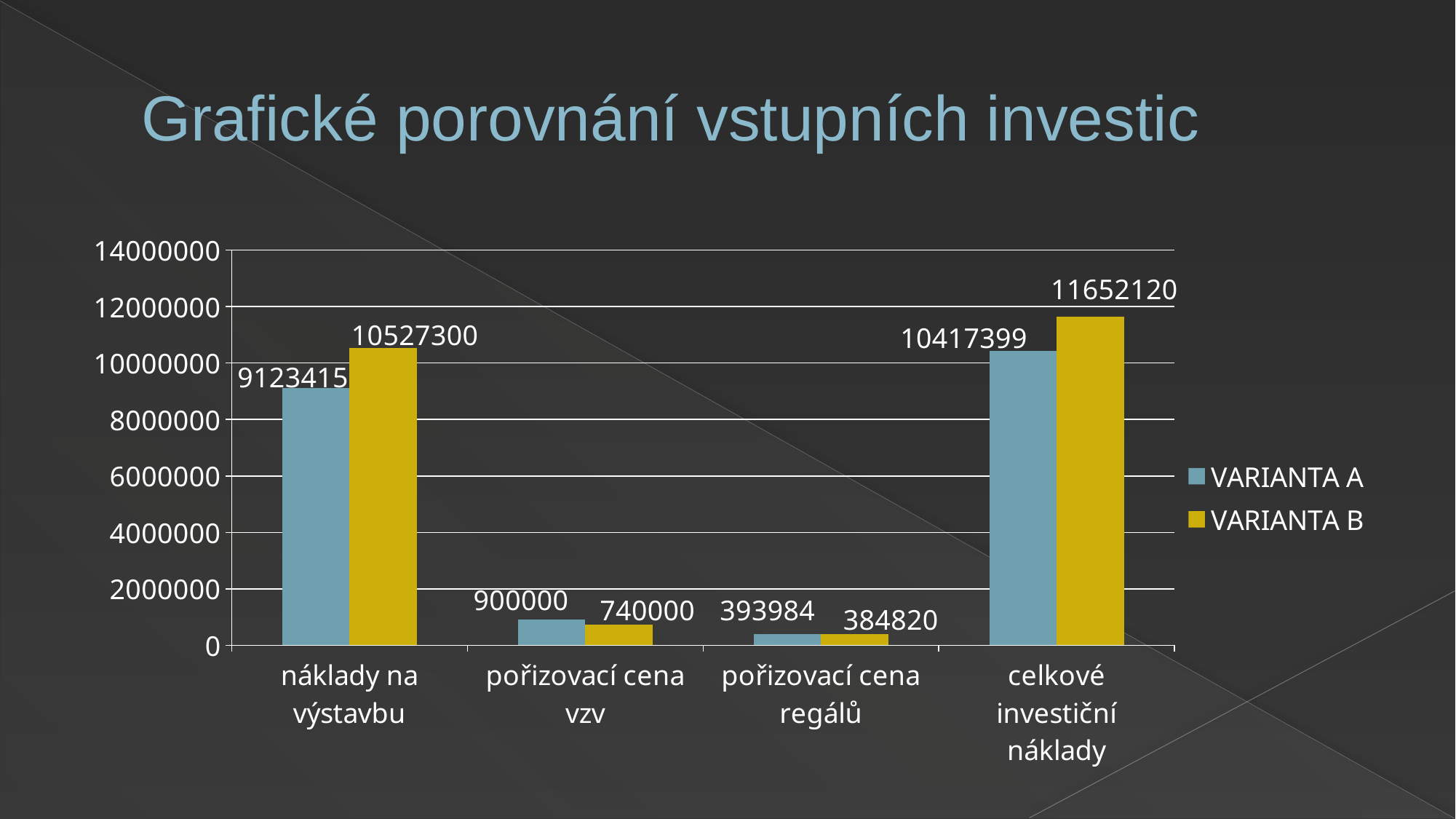
What is the value for VARIANTA B in the 'celkové investiční náklady' category? 11652120 How many categories are shown on the x axis? 4 In the 'pořizovací cena vzv' category, which series has the larger value, VARIANTA A or VARIANTA B? VARIANTA A What kind of chart is shown on the slide? bar chart What is the value for VARIANTA A in the 'pořizovací cena regálů' category? 393984 What is the difference between VARIANTA B and VARIANTA A in the 'celkové investiční náklady' category? 1234721 Which category has the highest value for VARIANTA B? celkové investiční náklady What is the value for VARIANTA A in the 'náklady na výstavbu' category? 9123415 What is the value for VARIANTA B in the 'pořizovací cena vzv' category? 740000 How many series does the legend list? 2 Is the value for VARIANTA B in 'náklady na výstavbu' greater or less than 10000000? greater Which category has the lowest value for VARIANTA A? pořizovací cena regálů